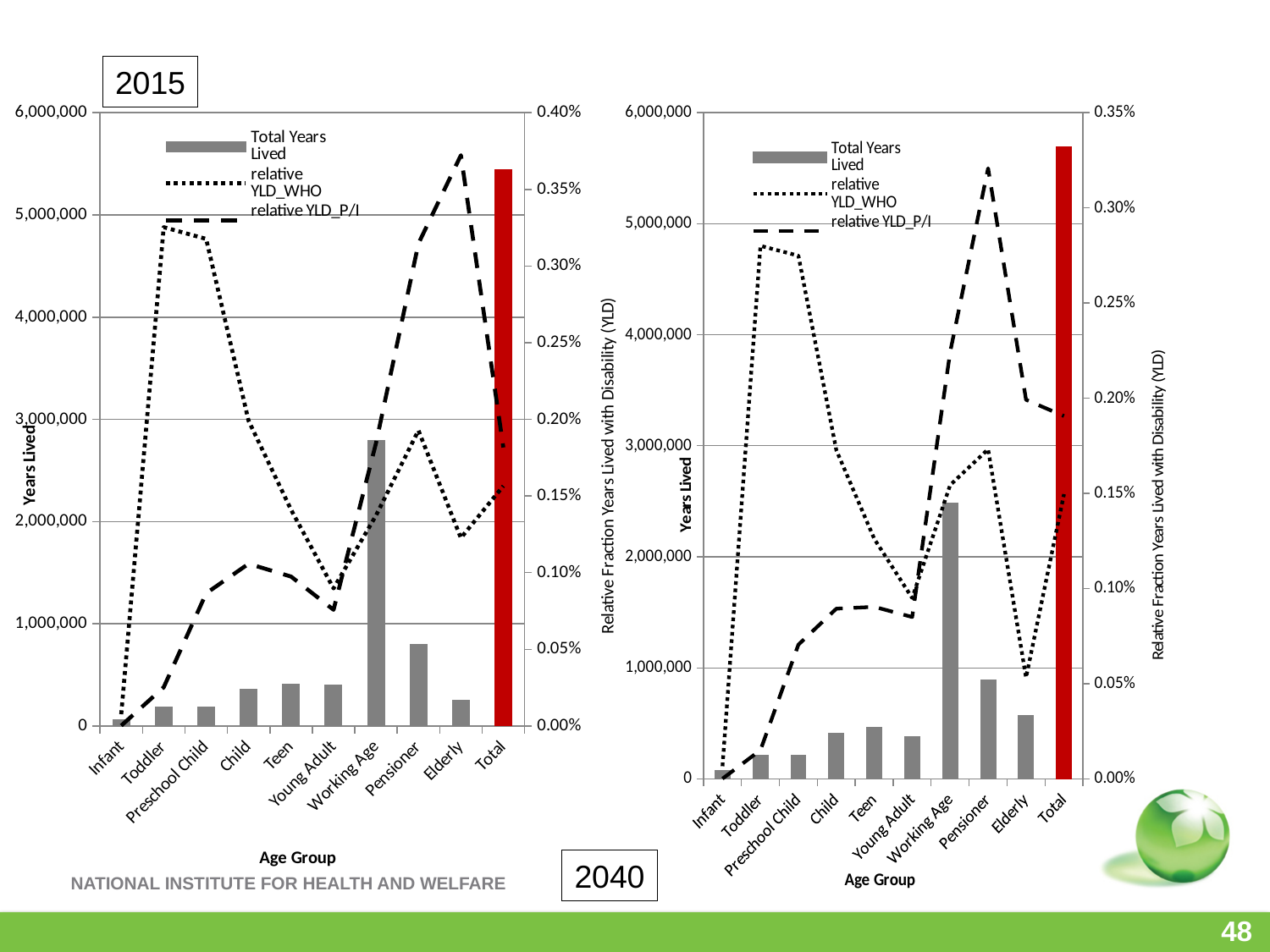
In the 2015 chart on the left, is the relative YLD_P/I value for Elderly greater or less than 0.35%? greater In the 2040 chart on the right, is the relative YLD_P/I value for Pensioner greater or less than 0.30%? greater In the 2015 chart on the left, is the Total Years Lived value for Working Age greater or less than 2,000,000? greater In the 2015 chart on the left, which has the larger Total Years Lived bar, Working Age or Pensioner? Working Age In the 2015 chart on the left, which age group (excluding Total) has the tallest Total Years Lived bar? Working Age How many series does the legend of the 2015 chart on the left list? 3 In the 2015 chart on the left, does the dotted relative YLD_WHO line rise or fall from Toddler to Young Adult? fall How many age group categories are shown on the x axis of the 2040 chart on the right? 10 In the 2040 chart on the right, which age group (excluding Total) has the shortest Total Years Lived bar? Infant What colour is the Total bar in the 2040 chart on the right? Red